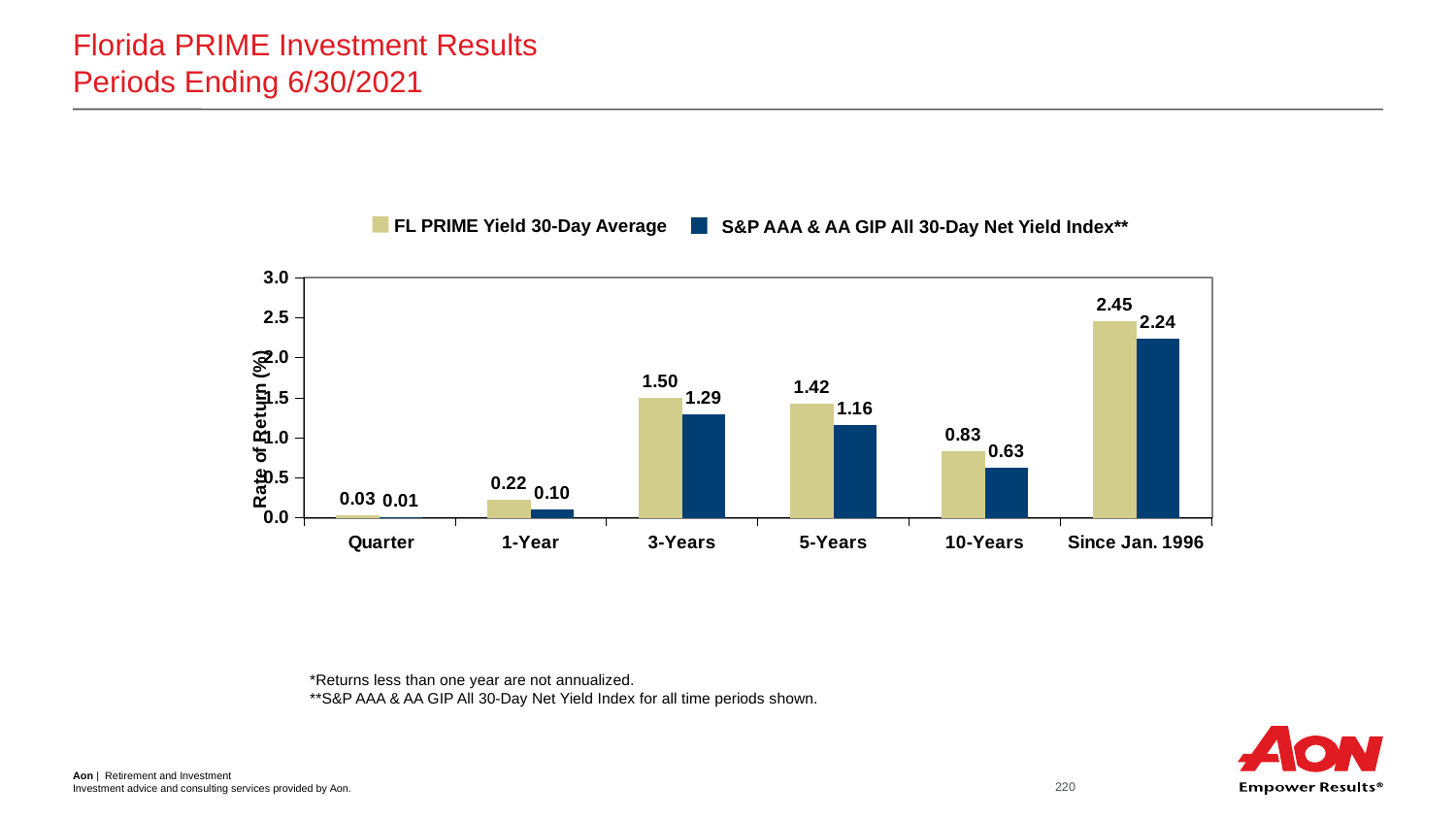
What is the FL PRIME Yield 30-Day Average for the 3-Years period? 1.50 How many time periods are shown on the x axis? 6 Which period has the lowest S&P AAA & AA GIP All 30-Day Net Yield Index value? Quarter Is the S&P AAA & AA GIP All 30-Day Net Yield Index value for Since Jan. 1996 greater or less than 2.0? greater What is the label of the y axis? Rate of Return (%) How many series does the legend list? 2 Which period has the highest FL PRIME Yield 30-Day Average? Since Jan. 1996 For the 1-Year period, which is larger: the FL PRIME Yield 30-Day Average or the S&P AAA & AA GIP All 30-Day Net Yield Index? FL PRIME Yield 30-Day Average What kind of chart is shown on the slide? Bar chart What is the difference between the FL PRIME Yield 30-Day Average and the S&P index value for the 10-Years period? 0.20 What is the S&P AAA & AA GIP All 30-Day Net Yield Index value for the 5-Years period? 1.16 What is the FL PRIME Yield 30-Day Average for the Quarter period? 0.03